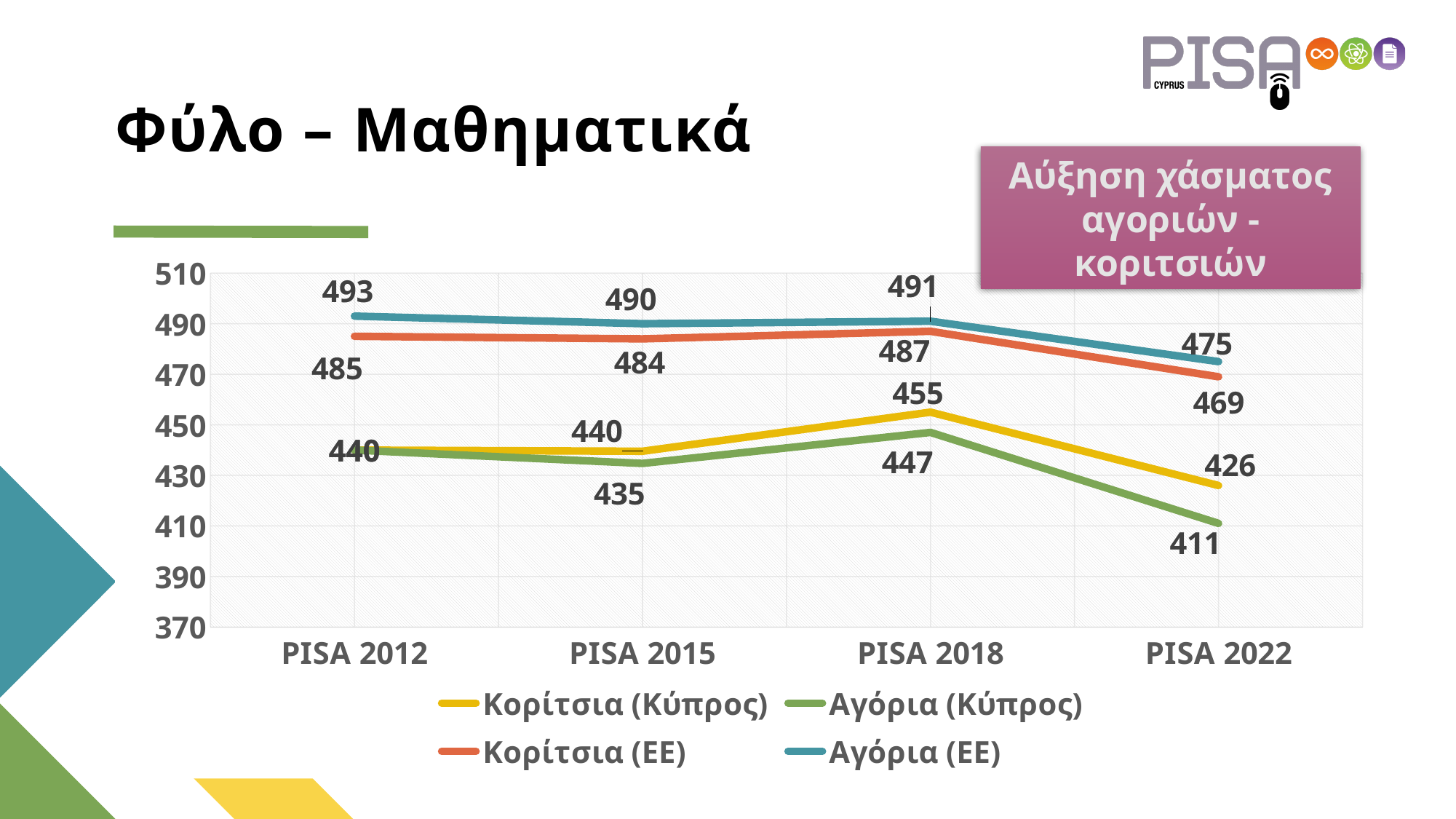
What is the difference between Αγόρια (ΕΕ) and Κορίτσια (ΕΕ) at PISA 2018? 4 What kind of chart is shown on the slide? line chart What is the value for Αγόρια (Κύπρος) at PISA 2022? 411 Which series has the highest value at PISA 2022? Αγόρια (ΕΕ) What is the value for Κορίτσια (Κύπρος) at PISA 2018? 455 What is the value for Κορίτσια (ΕΕ) at PISA 2015? 484 What is the difference between Κορίτσια (Κύπρος) and Αγόρια (Κύπρος) at PISA 2022? 15 In which PISA cycle does Αγόρια (Κύπρος) have its lowest value? PISA 2022 How many series does the legend list? 4 What is the value for Αγόρια (ΕΕ) at PISA 2022? 475 At PISA 2018, which is larger: Κορίτσια (Κύπρος) or Αγόρια (Κύπρος)? Κορίτσια (Κύπρος) How many PISA cycles are shown on the x axis? 4